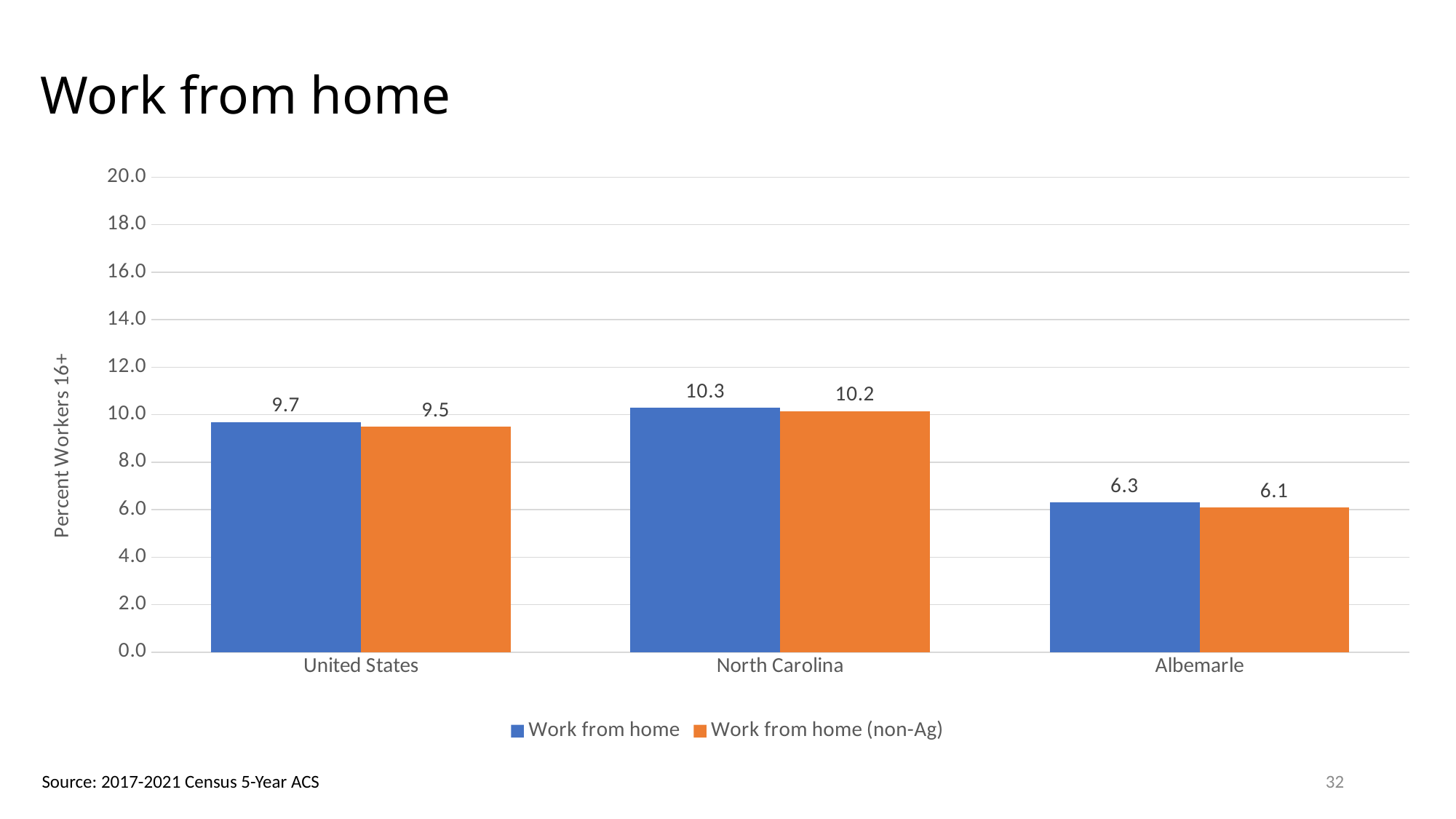
What is the Work from home value for North Carolina? 10.3 What is the difference between the Work from home and Work from home (non-Ag) values for the United States? 0.2 What is the difference between the Work from home values for North Carolina and Albemarle? 4.0 Is the Work from home (non-Ag) value for North Carolina greater or less than 8.0? greater What is the Work from home value for the United States? 9.7 What kind of chart is shown on the slide? Bar chart Which category has the highest Work from home value? North Carolina Which is larger: the Work from home value for the United States or for Albemarle? United States How many categories are shown on the x axis? 3 What is the Work from home (non-Ag) value for Albemarle? 6.1 How many series does the legend list? 2 Which category has the lowest Work from home (non-Ag) value? Albemarle